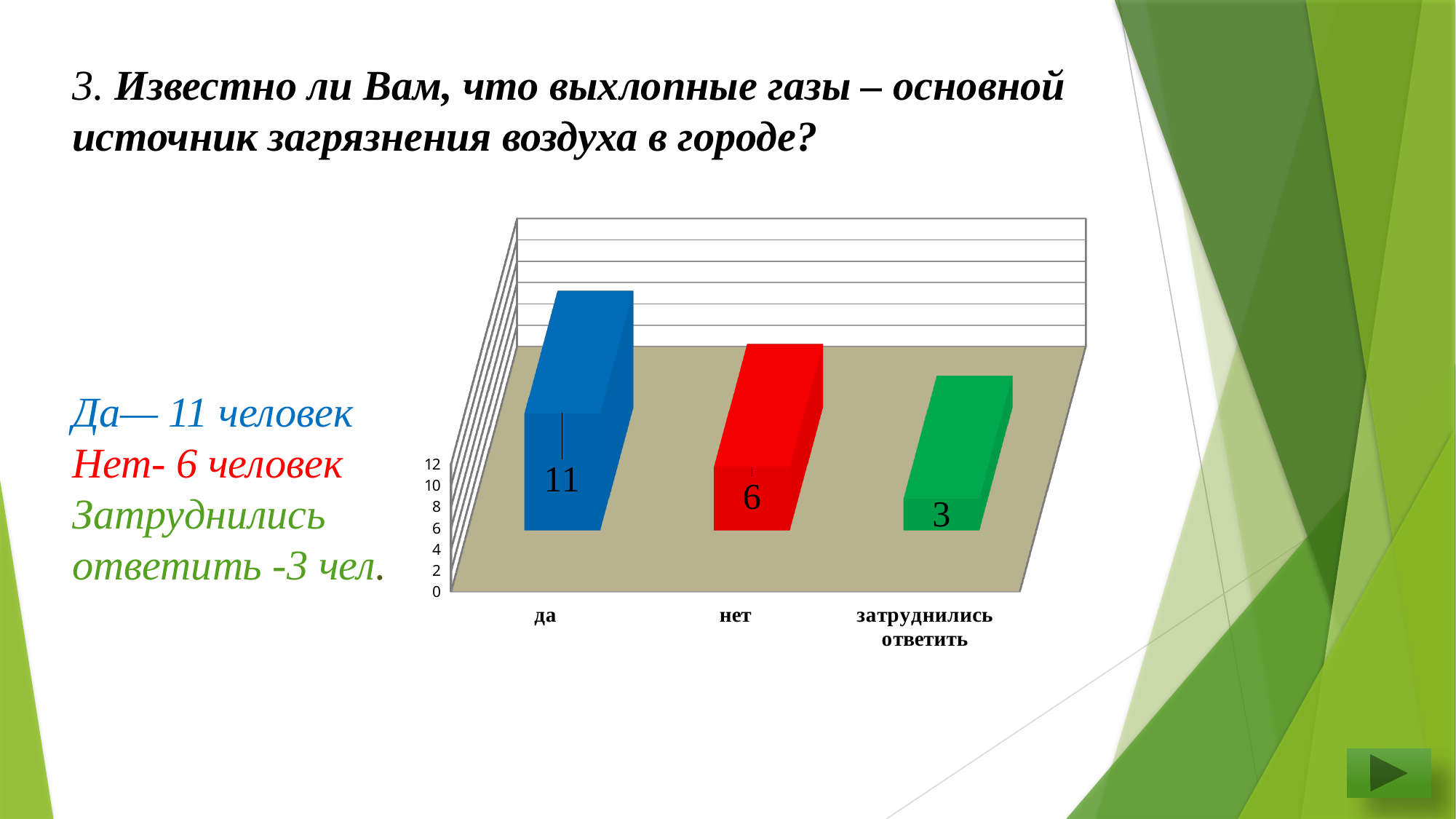
Which is larger, the value for "да" or the value for "нет"? да What kind of chart is shown on the slide? bar chart How many categories are shown on the x axis? 3 Which category has the highest value? да Which category has the lowest value? затруднились ответить What is the value for the category "затруднились ответить"? 3 What is the value for the category "да"? 11 What is the difference between the values for "нет" and "затруднились ответить"? 3 Is the value for "да" greater or less than 10? greater What colour is the bar for "нет"? red What is the value for the category "нет"? 6 What is the difference between the values for "да" and "нет"? 5